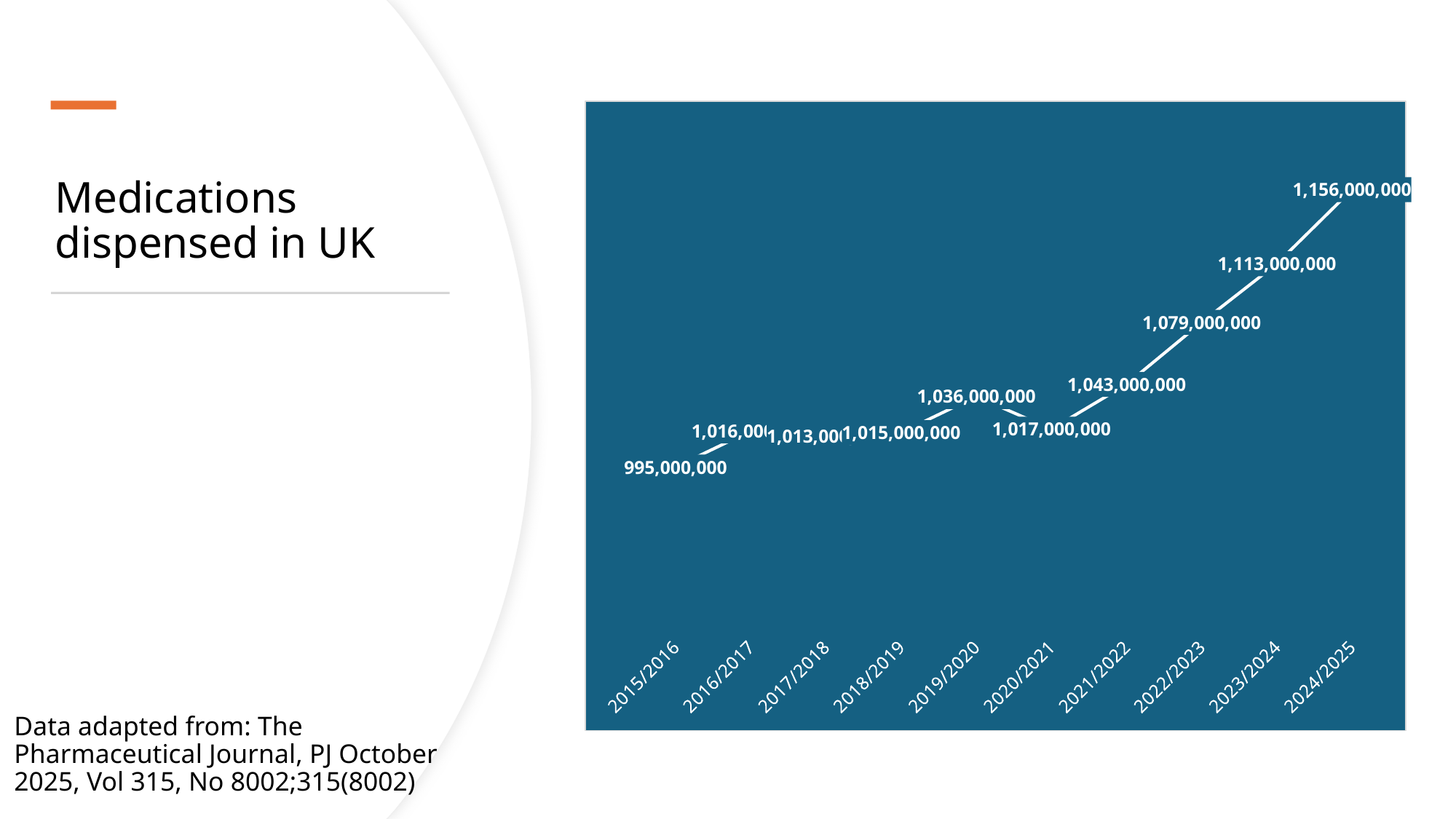
Which is larger, the value for 2019/2020 or the value for 2020/2021? 2019/2020 What is the value for 2015/2016? 995,000,000 Which year has the highest value? 2024/2025 What is the value for 2022/2023? 1,079,000,000 Do the values generally rise or fall from 2021/2022 to 2024/2025? Rise What is the value for 2019/2020? 1,036,000,000 What type of chart is shown on the slide? Line chart Which year has the lowest value? 2015/2016 What is the difference between the values for 2021/2022 and 2020/2021? 26,000,000 What is the value for 2024/2025? 1,156,000,000 What is the difference between the values for 2024/2025 and 2023/2024? 43,000,000 How many years are plotted on the x axis of the chart? 10